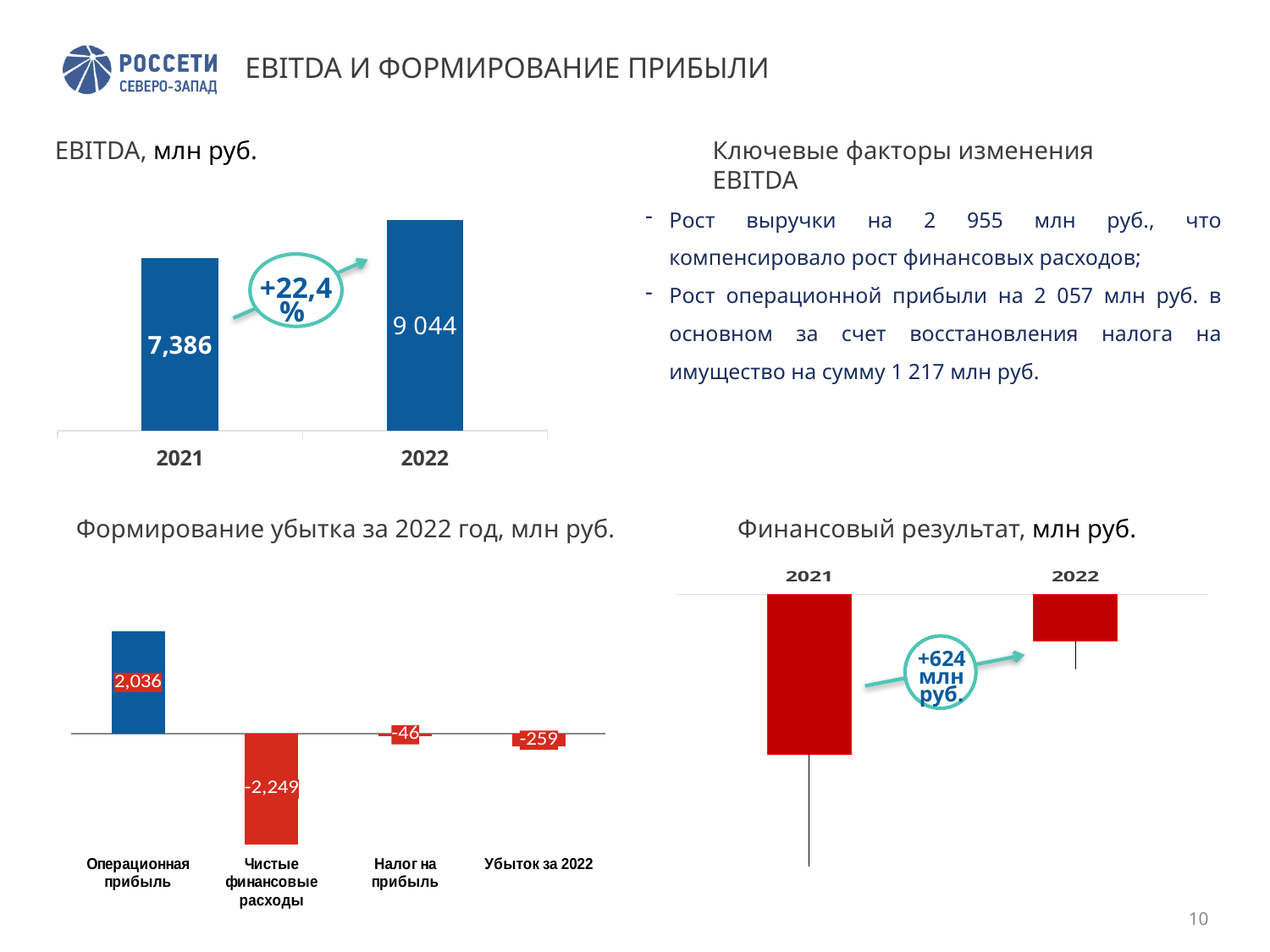
In the Формирование убытка за 2022 год chart, which category has the lowest value? Чистые финансовые расходы In the EBITDA, млн руб. chart, what is the value for 2021? 7,386 In the Формирование убытка за 2022 год chart, what is the value for Налог на прибыль? -46 In the EBITDA, млн руб. chart, which year has the higher EBITDA? 2022 In the EBITDA, млн руб. chart, what percentage change is shown between 2021 and 2022? +22,4% In the Формирование убытка за 2022 год chart, what is the value for Чистые финансовые расходы? -2,249 How many categories are shown in the Формирование убытка за 2022 год chart? 4 In the EBITDA, млн руб. chart, what is the value for 2022? 9 044 What kind of chart is the EBITDA, млн руб. chart? bar chart In the Финансовый результат, млн руб. chart, what change between 2021 and 2022 is shown in the annotation? +624 млн руб. In the Формирование убытка за 2022 год chart, what is the value for Операционная прибыль? 2,036 In the Формирование убытка за 2022 год chart, what is the value for Убыток за 2022? -259